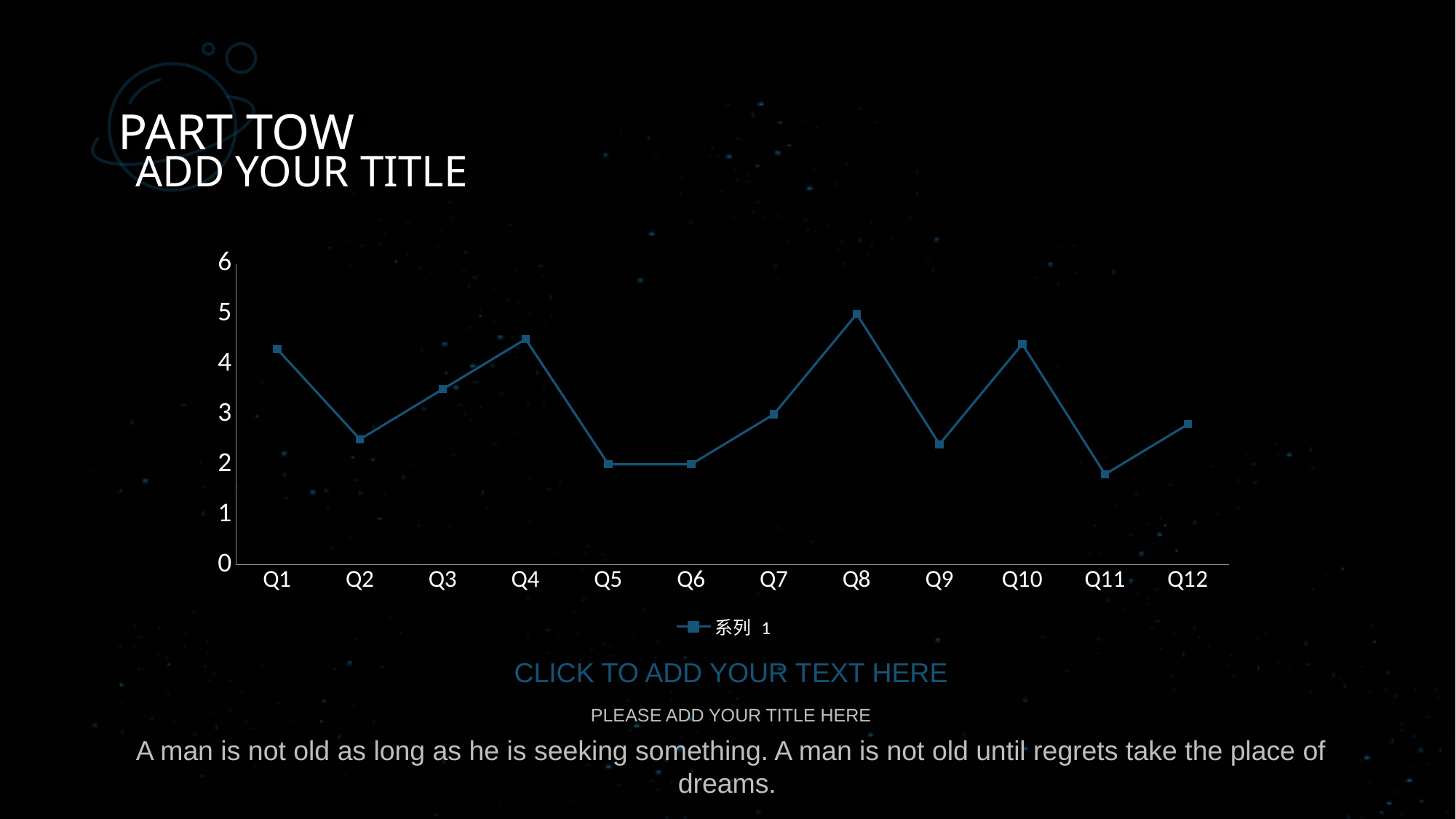
What is the name of the series shown in the chart's legend? 系列 1 How many series does the chart's legend list? 1 Is the value for Q10 greater or less than 4? greater What kind of chart is shown on the slide? line chart Is the value for Q9 greater or less than 3? less Is the value for Q12 greater or less than 3? less Which quarter has the lowest value in the chart? Q11 Which is larger, the value for Q4 or the value for Q2? Q4 Do the values rise or fall from Q6 to Q8? rise How many points are plotted along the x axis of the chart? 12 Which quarter has the highest value in the chart? Q8